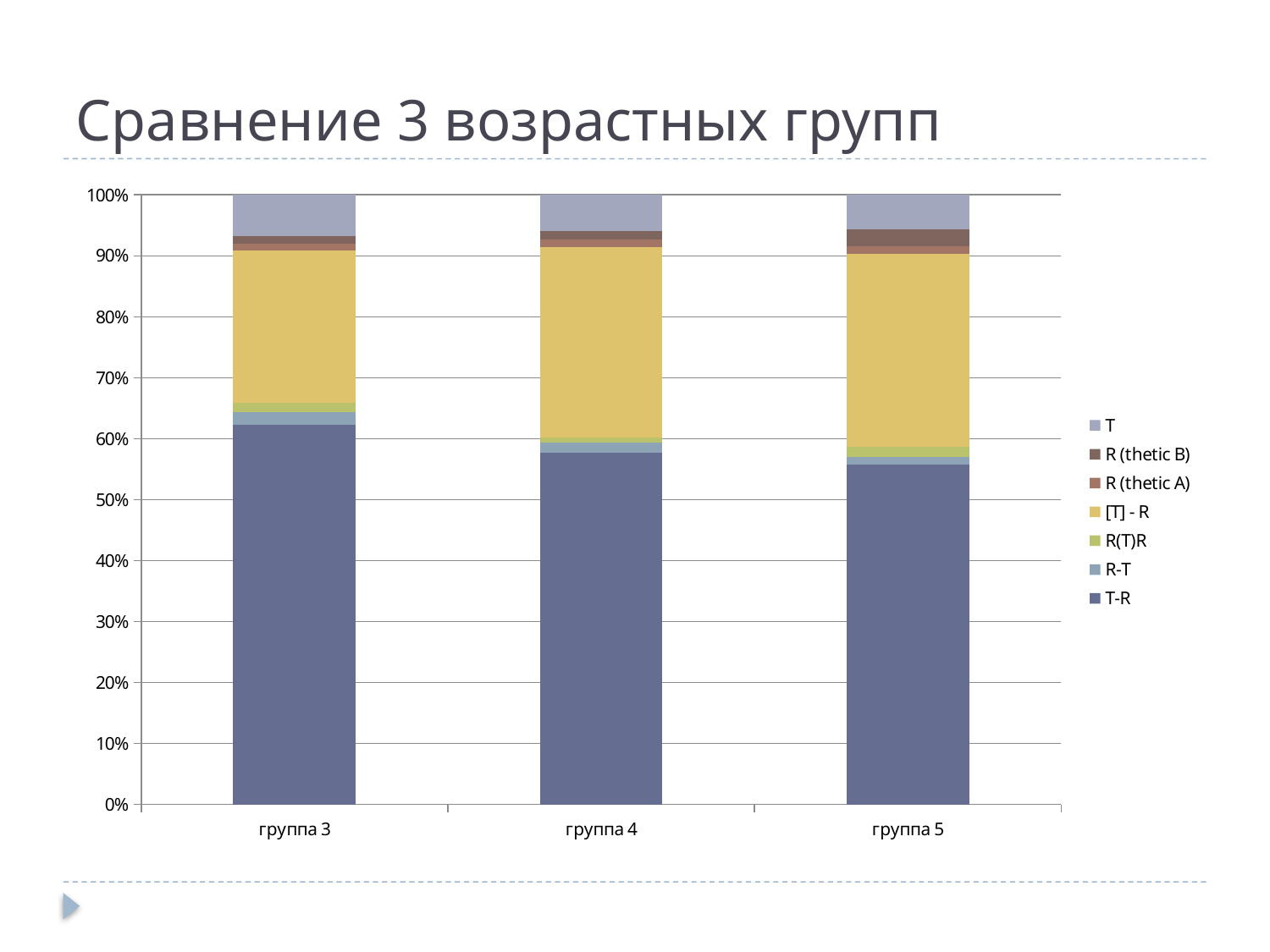
How many groups (categories) are shown on the x axis? 3 Which group has the largest T-R share? группа 3 Is the T-R value for группа 4 greater or less than 60%? less What is the title of the slide? Сравнение 3 возрастных групп How many series does the legend list? 7 What kind of chart is shown on the slide? stacked bar chart Which series is listed first in the legend? T What is the total height of each stacked bar? 100% What is the label of the middle category on the x axis? группа 4 Which is larger, the T-R share for группа 3 or for группа 5? группа 3 Is the T-R value for группа 3 greater or less than 60%? greater Is the T-R value for группа 5 greater or less than 60%? less